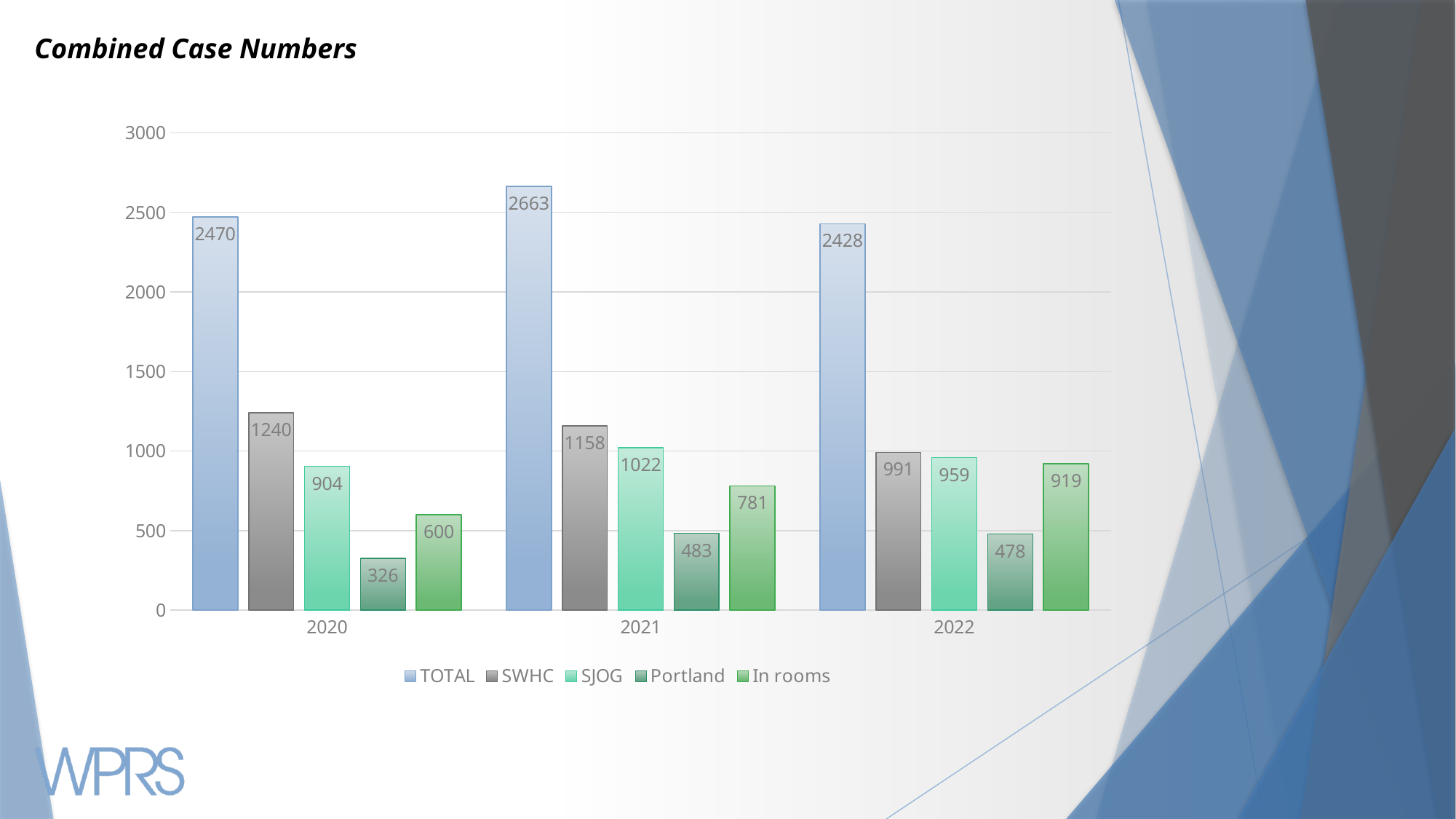
What kind of chart is shown on the slide? Bar chart In which year is the TOTAL value highest? 2021 Do the In rooms values rise or fall from 2020 to 2022? Rise Which is larger in 2022: the SWHC value or the SJOG value? SWHC What is the TOTAL value for 2021? 2663 How many series does the legend list? 5 How many years are shown on the x axis? 3 What is the SWHC value for 2020? 1240 What is the Portland value for 2021? 483 In which year is the Portland value lowest? 2020 What is the difference between the SJOG values for 2021 and 2020? 118 What is the In rooms value for 2022? 919